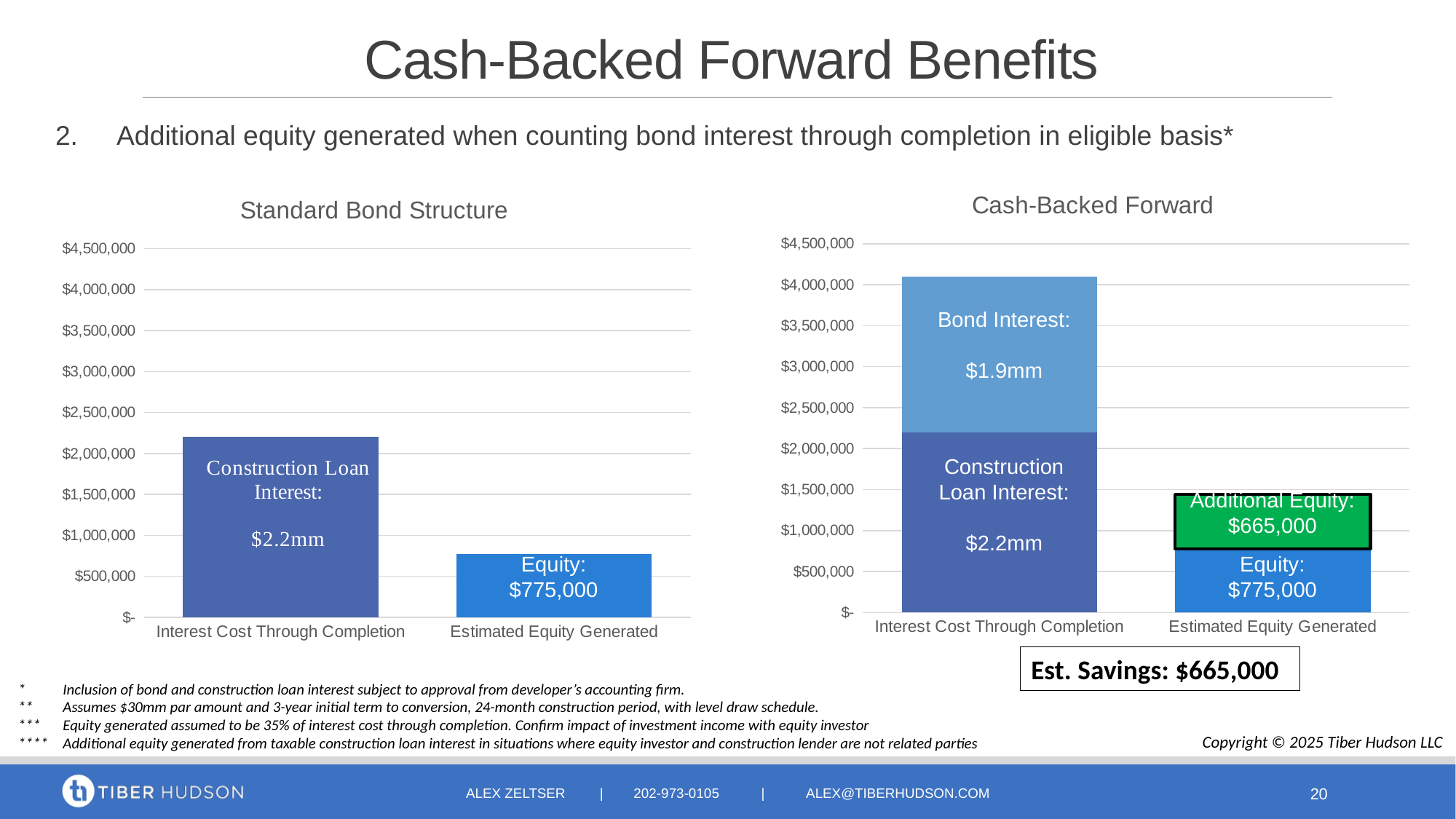
How many categories are shown on the x axis of the Standard Bond Structure chart? 2 In the Cash-Backed Forward chart, what is the Additional Equity value shown on the Estimated Equity Generated bar? $665,000 In the Standard Bond Structure chart, what is the Construction Loan Interest value shown on the Interest Cost Through Completion bar? $2.2mm In the Cash-Backed Forward chart, what is the total of the Interest Cost Through Completion stacked bar (Construction Loan Interest plus Bond Interest)? $4.1mm In the Standard Bond Structure chart, what is the Equity value shown on the Estimated Equity Generated bar? $775,000 In the Cash-Backed Forward chart, what is the difference between the Equity segment and the Additional Equity segment? $110,000 In the Cash-Backed Forward chart, what is the Bond Interest value shown on the Interest Cost Through Completion bar? $1.9mm In the Cash-Backed Forward chart, what is the total of the Estimated Equity Generated stacked bar (Equity plus Additional Equity)? $1,440,000 In the Cash-Backed Forward chart, which is larger on the Interest Cost Through Completion bar: Construction Loan Interest or Bond Interest? Construction Loan Interest What kind of chart is the Cash-Backed Forward chart? Bar chart In the Standard Bond Structure chart, is the value for Interest Cost Through Completion greater or less than $2,000,000? greater In the Standard Bond Structure chart, is the value for Estimated Equity Generated greater or less than $1,000,000? less